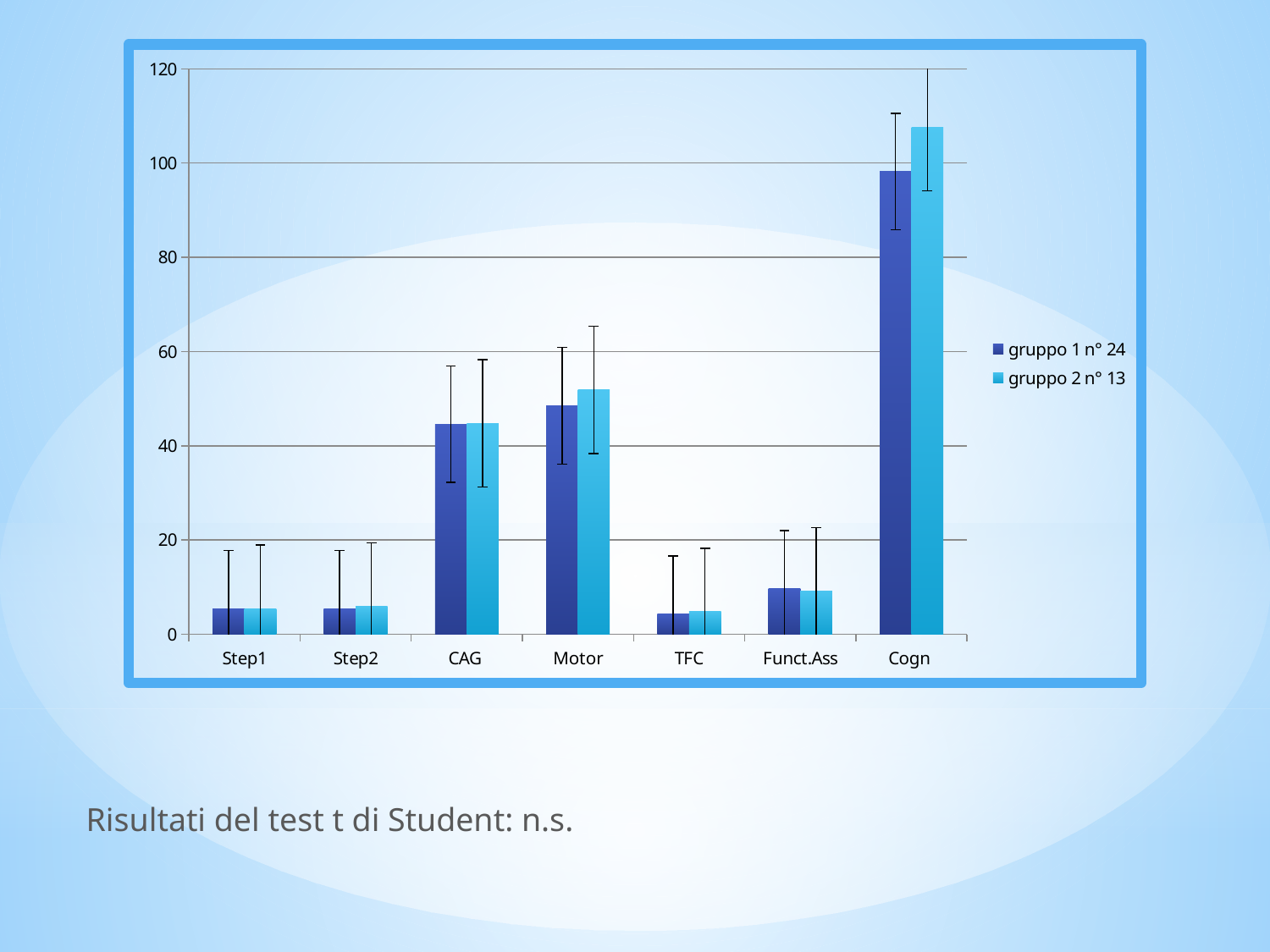
For gruppo 2 n° 13, which category has the larger value, Motor or CAG? Motor What kind of chart is shown on the slide? bar chart Which category has the highest value for gruppo 1 n° 24? Cogn Is the value for Cogn in gruppo 2 n° 13 greater or less than 100? greater What are the two series names listed in the chart's legend? gruppo 1 n° 24 and gruppo 2 n° 13 Which category has the highest value for gruppo 2 n° 13? Cogn How many series does the chart's legend list? 2 How many categories are shown on the x axis of the chart? 7 Is the value for Funct.Ass in gruppo 1 n° 24 greater or less than 20? less Is the value for CAG in gruppo 1 n° 24 greater or less than 60? less For Cogn, which series has the larger value, gruppo 1 n° 24 or gruppo 2 n° 13? gruppo 2 n° 13